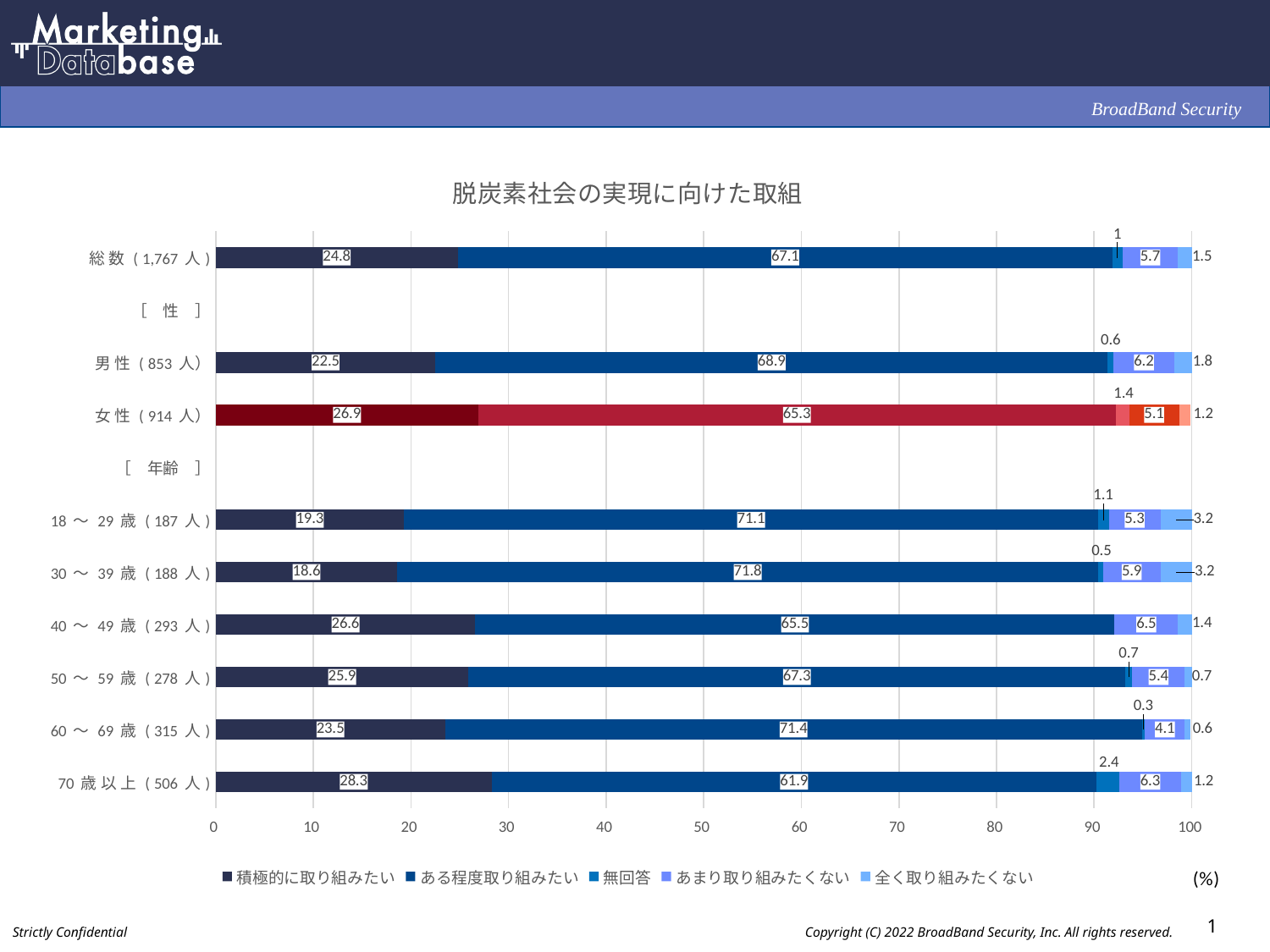
What is the value of 無回答 for 70歳以上 (506人)? 2.4 What type of chart is shown on the slide? Stacked horizontal bar chart What is the difference in 積極的に取り組みたい between 女性 (914人) and 男性 (853人)? 4.4 Which group has the highest value for 積極的に取り組みたい? 70歳以上 (506人) What is the value of 積極的に取り組みたい for 総数 (1,767人)? 24.8 Which group has the lowest value for 積極的に取り組みたい? 30～39歳 (188人) How many series does the legend list? 5 What is the value of ある程度取り組みたい for 女性 (914人)? 65.3 Which is larger, the ある程度取り組みたい value for 30～39歳 (188人) or for 40～49歳 (293人)? 30～39歳 (188人) How many respondent groups (bars) are plotted in the chart? 9 What is the title of the chart? 脱炭素社会の実現に向けた取組 What is the value of 全く取り組みたくない for 18～29歳 (187人)? 3.2